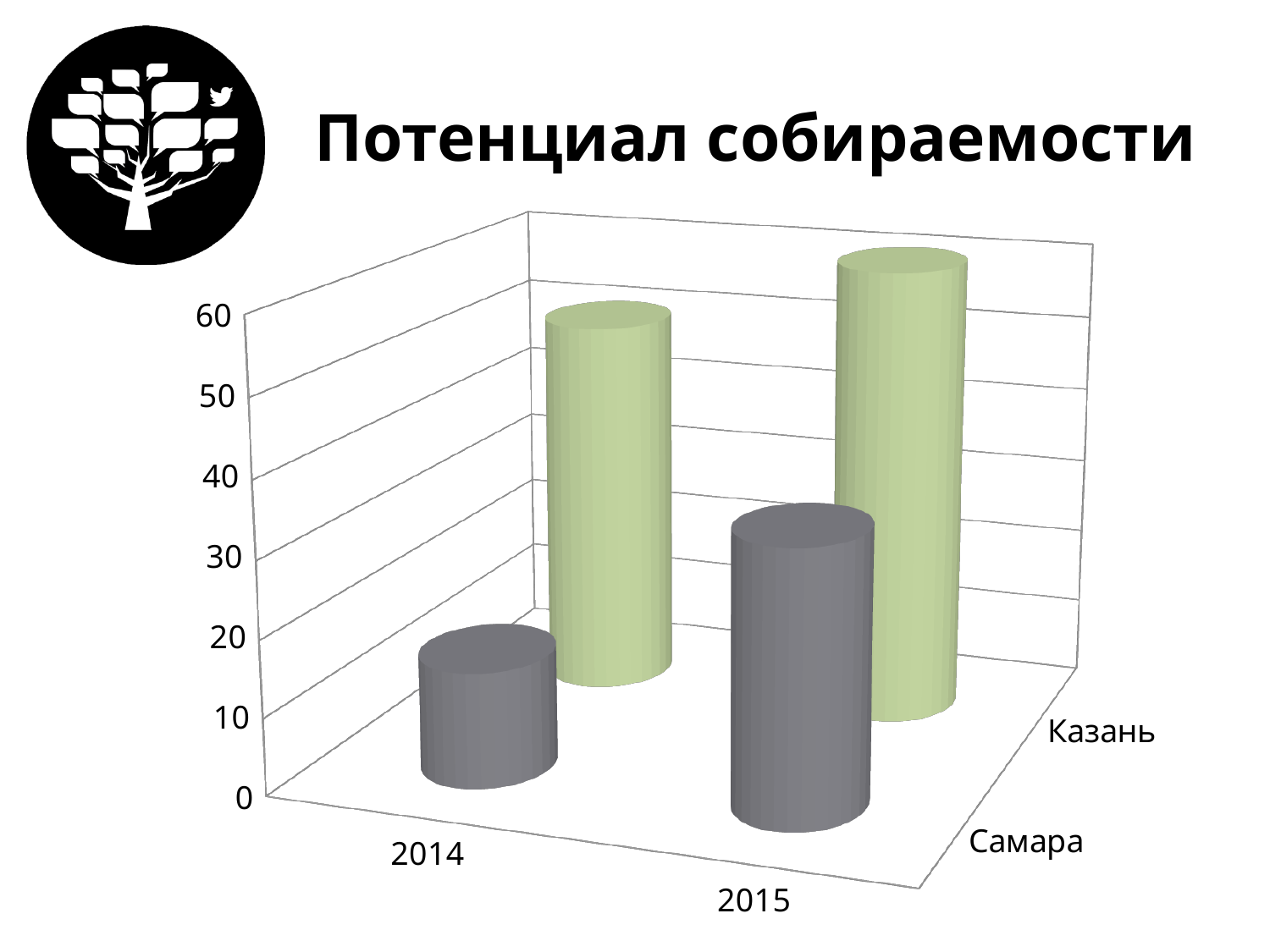
For Самара, which year has the larger value, 2014 or 2015? 2015 What colour are the bars for Казань? green Is the value for Самара in 2014 greater or less than 30? less Which is larger: Казань in 2014 or Самара in 2015? Казань in 2014 What is the title of the chart? Потенциал собираемости Is the value for Казань in 2015 greater or less than 50? greater Which bar is the highest in the chart? Казань, 2015 Do the values for Казань rise or fall from 2014 to 2015? rise What kind of chart is shown on the slide? bar chart How many years are shown on the x axis of the chart? 2 Which bar is the lowest in the chart? Самара, 2014 How many series (cities) does the chart show? 2